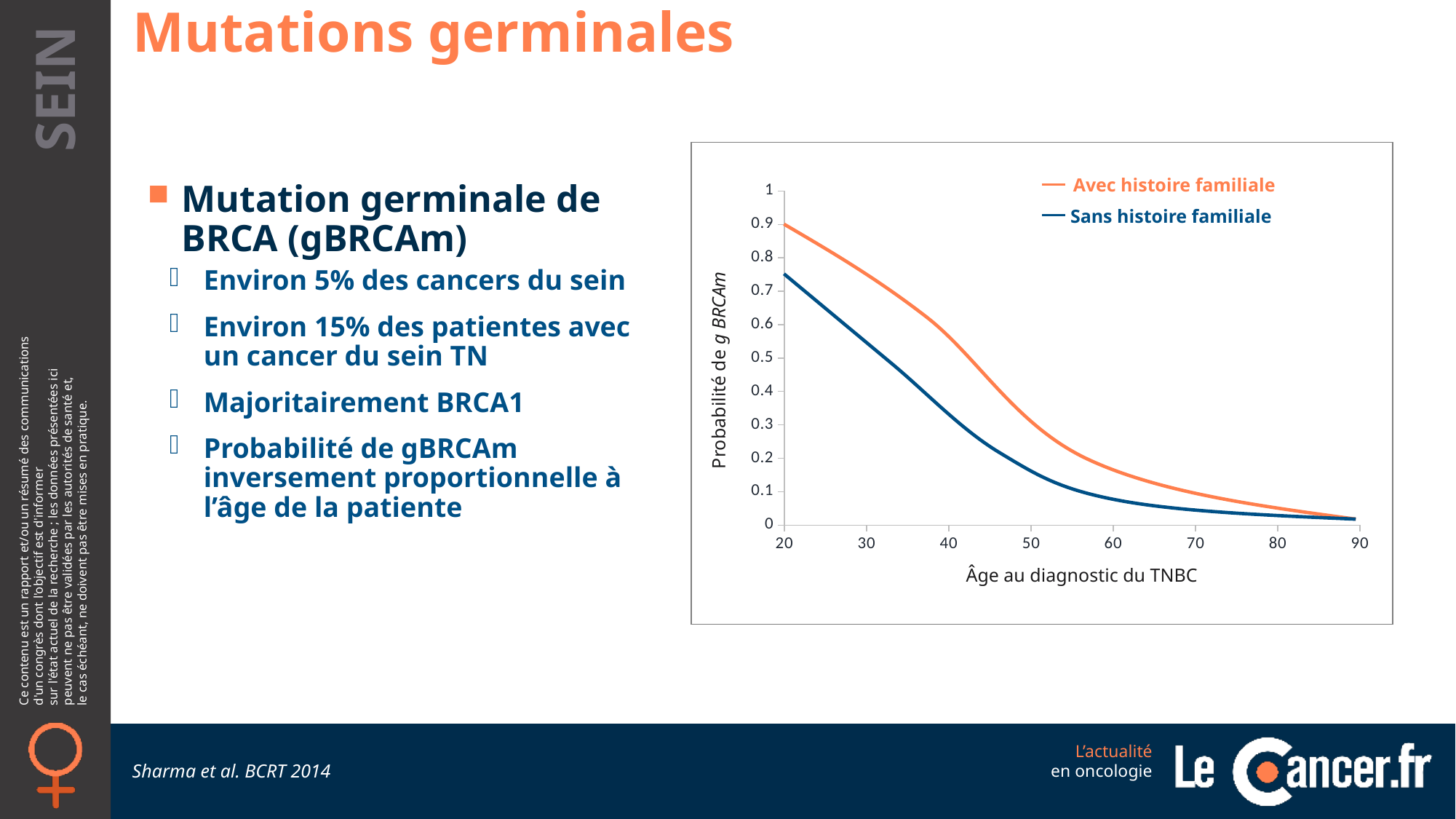
Which colour is used for the 'Sans histoire familiale' series in the chart? blue At age 40, which series has the higher probability: 'Avec histoire familiale' or 'Sans histoire familiale'? Avec histoire familiale How many age tick labels are shown on the x axis of the chart? 8 What is the label of the x axis of the chart? Âge au diagnostic du TNBC Is the value for 'Sans histoire familiale' at age 50 greater or less than 0.2? less What kind of chart is shown on the slide? line chart Is the value for 'Sans histoire familiale' at age 20 greater or less than 0.8? less Do the values of the 'Avec histoire familiale' series rise or fall as age increases along the x axis? fall How many series does the chart legend list? 2 Is the value for 'Avec histoire familiale' at age 20 greater or less than 0.8? greater Do the values of the 'Sans histoire familiale' series rise or fall as age increases along the x axis? fall